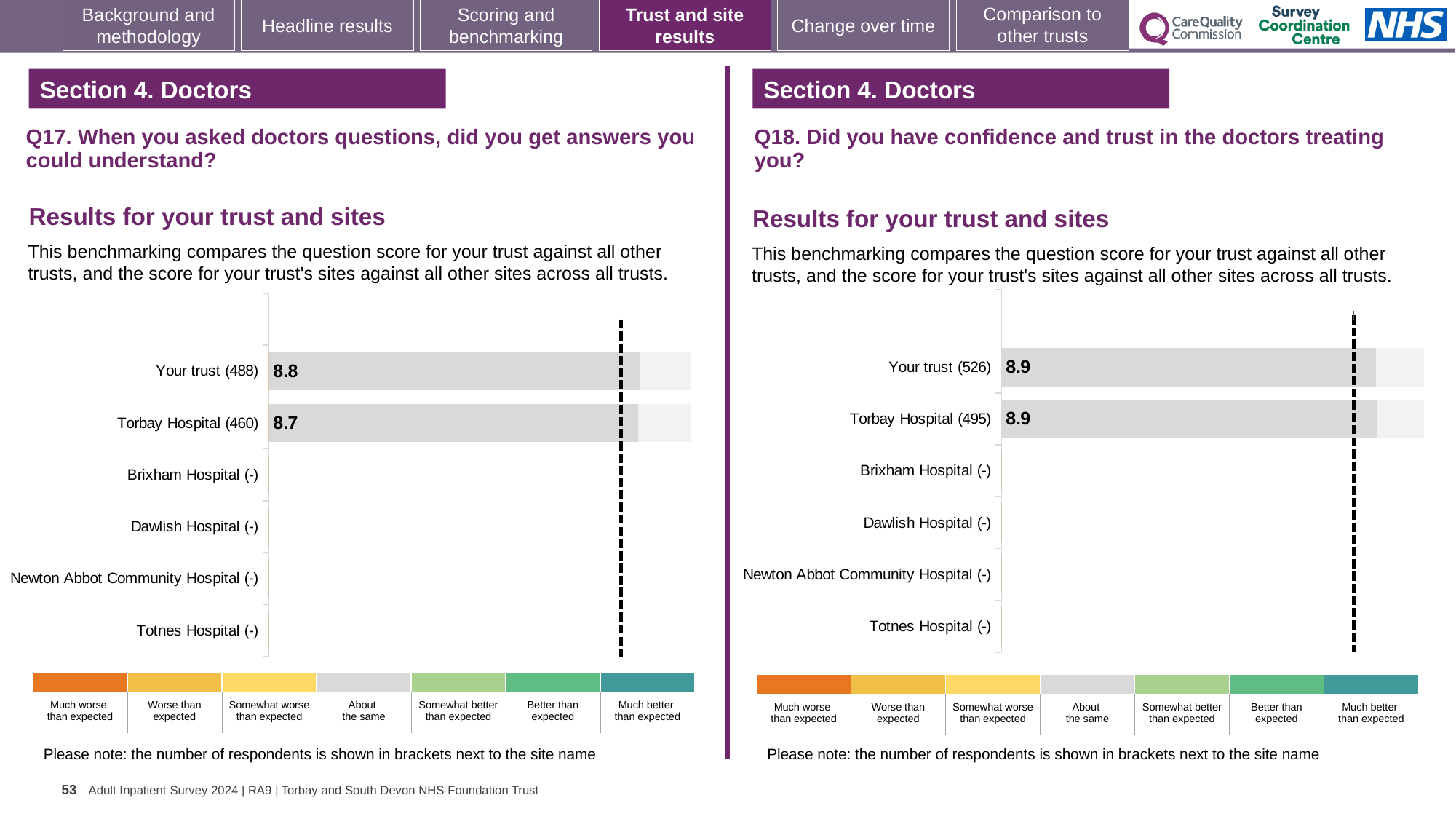
On the Q18 chart (right), how many categories in the colour key below the chart? 7 On the Q18 chart (right), what is the score for Torbay Hospital? 8.9 On the Q18 chart (right), how many respondents are shown in brackets for Your trust? 526 On the Q17 chart (left), what is the score for Your trust? 8.8 On the Q17 chart (left), what is the difference between the Your trust score and the Torbay Hospital score? 0.1 On the Q17 chart (left), which sites have no score shown (marked with a dash)? Brixham Hospital, Dawlish Hospital, Newton Abbot Community Hospital, Totnes Hospital On the Q18 chart (right), what is the score for Your trust? 8.9 On the Q17 chart (left), how many respondents are shown in brackets for Torbay Hospital? 460 On the Q17 chart (left), what is the score for Torbay Hospital? 8.7 What kind of chart is used on the Q18 chart (right)? Bar chart On the Q17 chart (left), how many sites or categories are listed on the vertical axis? 6 On the Q17 chart (left), which has the higher score, Your trust or Torbay Hospital? Your trust